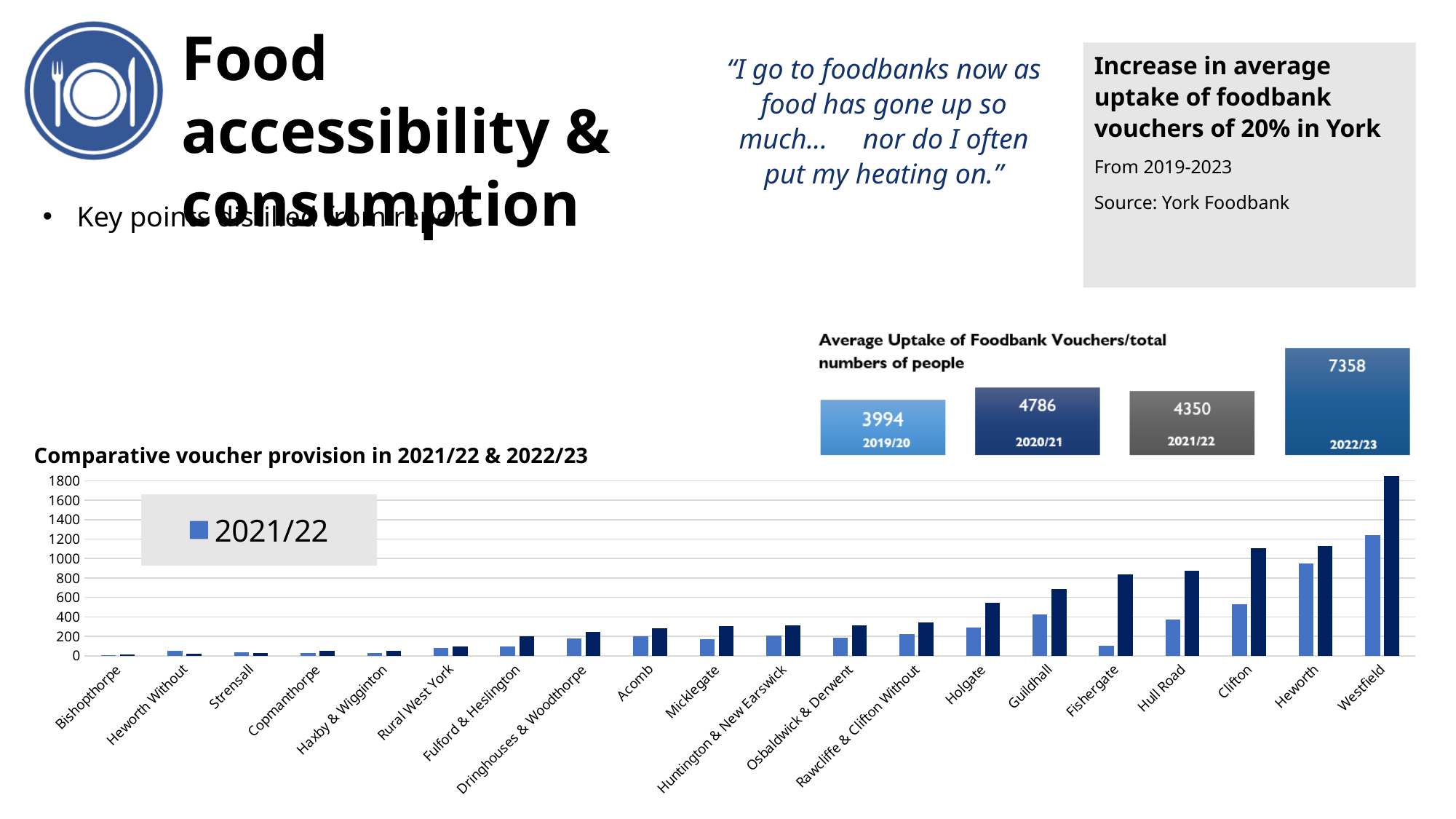
In the 'Average Uptake of Foodbank Vouchers/total numbers of people' graphic, which year has the highest value? 2022/23 In the 'Comparative voucher provision in 2021/22 & 2022/23' chart, which ward has the highest bar? Westfield In the 'Comparative voucher provision in 2021/22 & 2022/23' chart, is the light blue 2021/22 value for Westfield greater or less than 1000? greater In the 'Comparative voucher provision in 2021/22 & 2022/23' chart, is the dark blue value for Holgate greater or less than 400? greater In the 'Average Uptake of Foodbank Vouchers/total numbers of people' graphic, what is the difference between the 2022/23 value and the 2019/20 value? 3364 In the 'Comparative voucher provision in 2021/22 & 2022/23' chart, which ward has the lowest bars? Bishopthorpe In the 'Average Uptake of Foodbank Vouchers/total numbers of people' graphic, what is the value for 2022/23? 7358 In the 'Comparative voucher provision in 2021/22 & 2022/23' chart, do the values generally rise or fall from left to right along the x axis? rise What kind of chart is 'Comparative voucher provision in 2021/22 & 2022/23'? bar chart In the 'Comparative voucher provision in 2021/22 & 2022/23' chart, is the dark blue value for Hull Road greater or less than 1000? less In the 'Comparative voucher provision in 2021/22 & 2022/23' chart, which series does the legend list? 2021/22 In the 'Comparative voucher provision in 2021/22 & 2022/23' chart, how many wards are shown on the x axis? 20